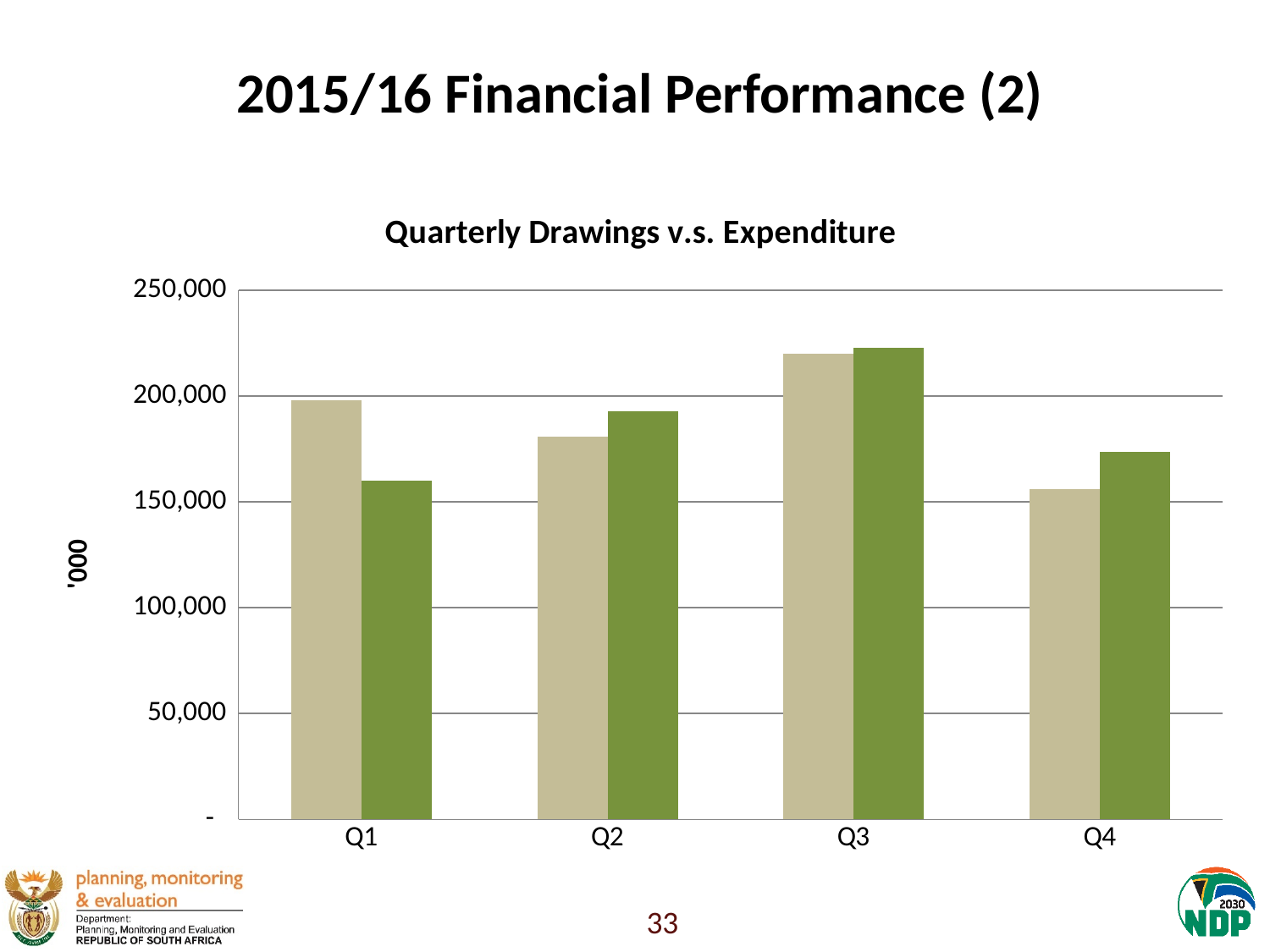
In which quarter is the green bar the lowest? Q1 What is the title of the chart? Quarterly Drawings v.s. Expenditure Is the value of the green bar for Q2 greater or less than 200,000? less In which quarter is the green bar the highest? Q3 In which quarter is the tan (light) bar the highest? Q3 In which quarter is the tan (light) bar the lowest? Q4 How many quarters are shown on the x axis of the chart? 4 In Q4, which bar is larger, the tan (light) bar or the green bar? the green bar Is the value of the tan (light) bar for Q3 greater or less than 200,000? greater What kind of chart is shown on the slide? bar chart What is the label on the vertical axis of the chart? '000 In Q1, which bar is larger, the tan (light) bar or the green bar? the tan bar